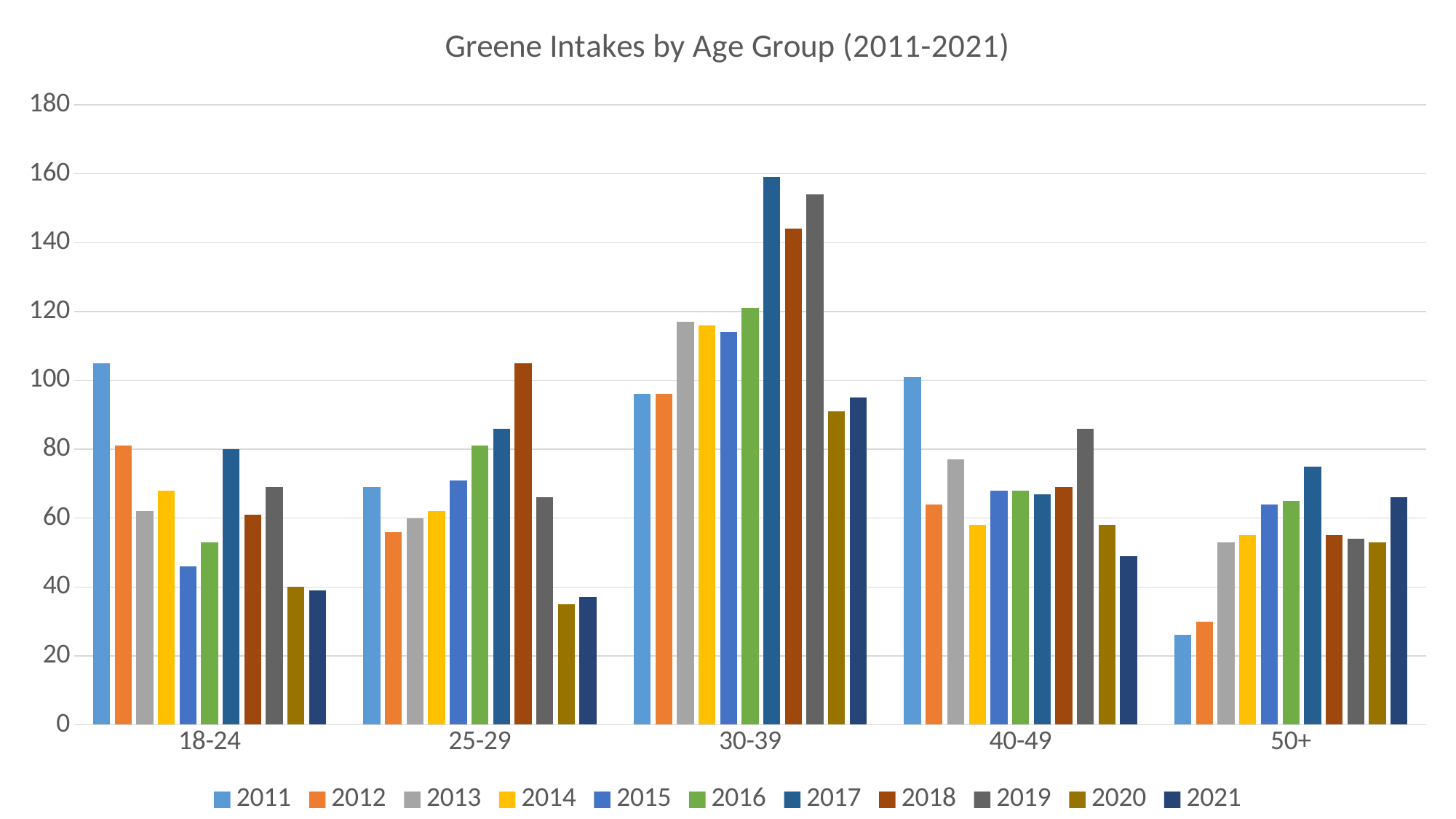
In the 18-24 age group, which is larger: the 2011 bar or the 2021 bar? 2011 How many series (years) does the legend list? 11 Within the 30-39 age group, which year has the highest bar? 2017 Is the value for 2011 in the 50+ age group greater or less than 40? less What kind of chart is shown on the slide? Bar chart Within the 50+ age group, which year has the lowest bar? 2011 What is the title of the chart? Greene Intakes by Age Group (2011-2021) Which age group has the highest bar for 2017? 30-39 Is the value for 2017 in the 30-39 age group greater or less than 140? greater Within the 18-24 age group, which year has the highest bar? 2011 In the 25-29 age group, which is larger: the 2018 bar or the 2020 bar? 2018 How many age groups are shown on the x axis? 5